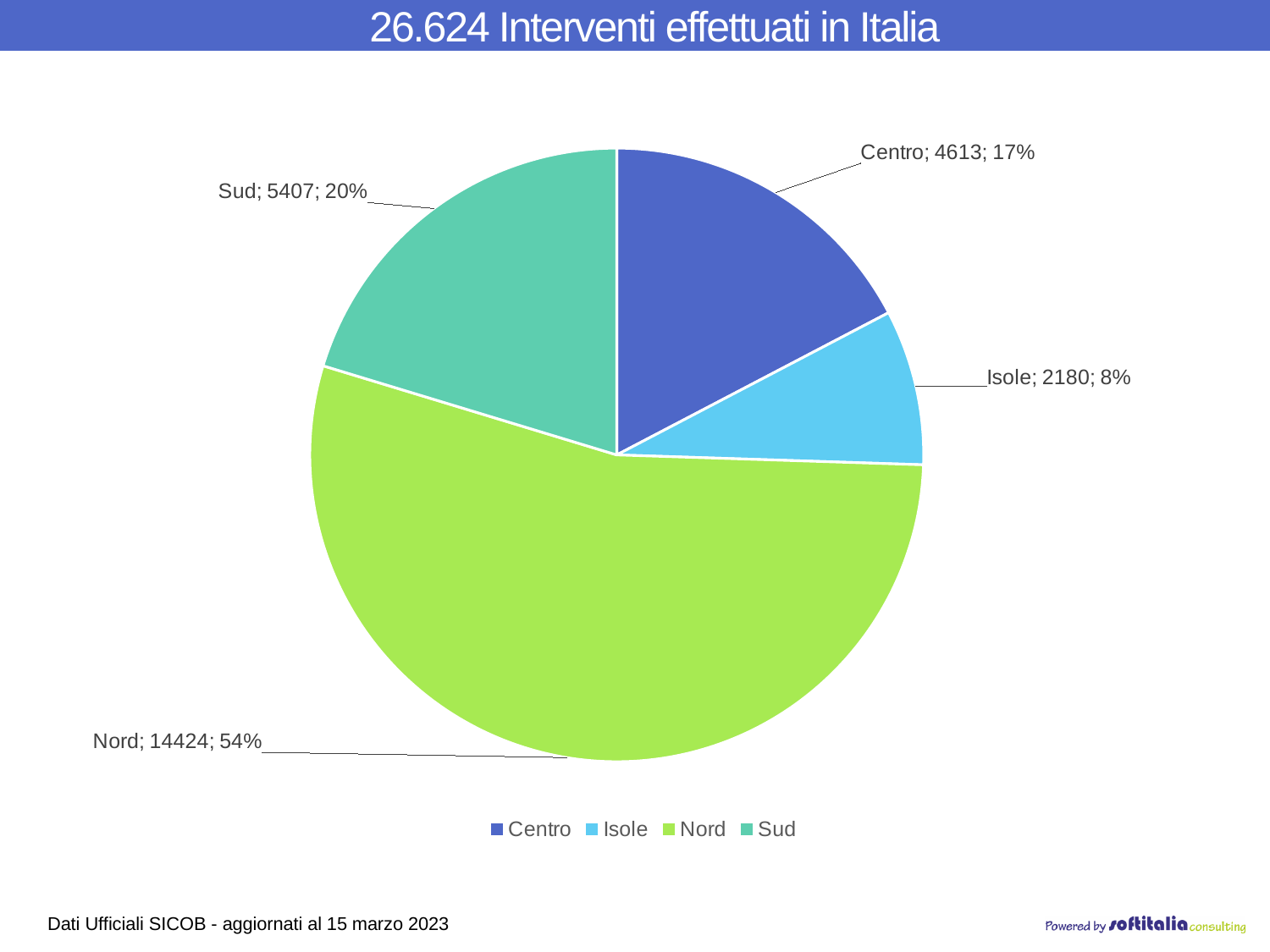
Which region has the largest slice of the pie? Nord Which entries are listed in the legend? Centro, Isole, Nord, Sud Which is larger, the value for Centro or the value for Isole? Centro What is the difference between the values for Sud and Centro? 794 What is the value shown for Isole? 2180 What type of chart is shown on the slide? pie chart What is the title of the chart? 26.624 Interventi effettuati in Italia How many interventions were carried out in the Nord region? 14424 Which region has the smallest slice of the pie? Isole What percentage share does Sud have in the pie chart? 20% How many categories does the pie chart have? 4 What percentage share does Centro have in the pie chart? 17%